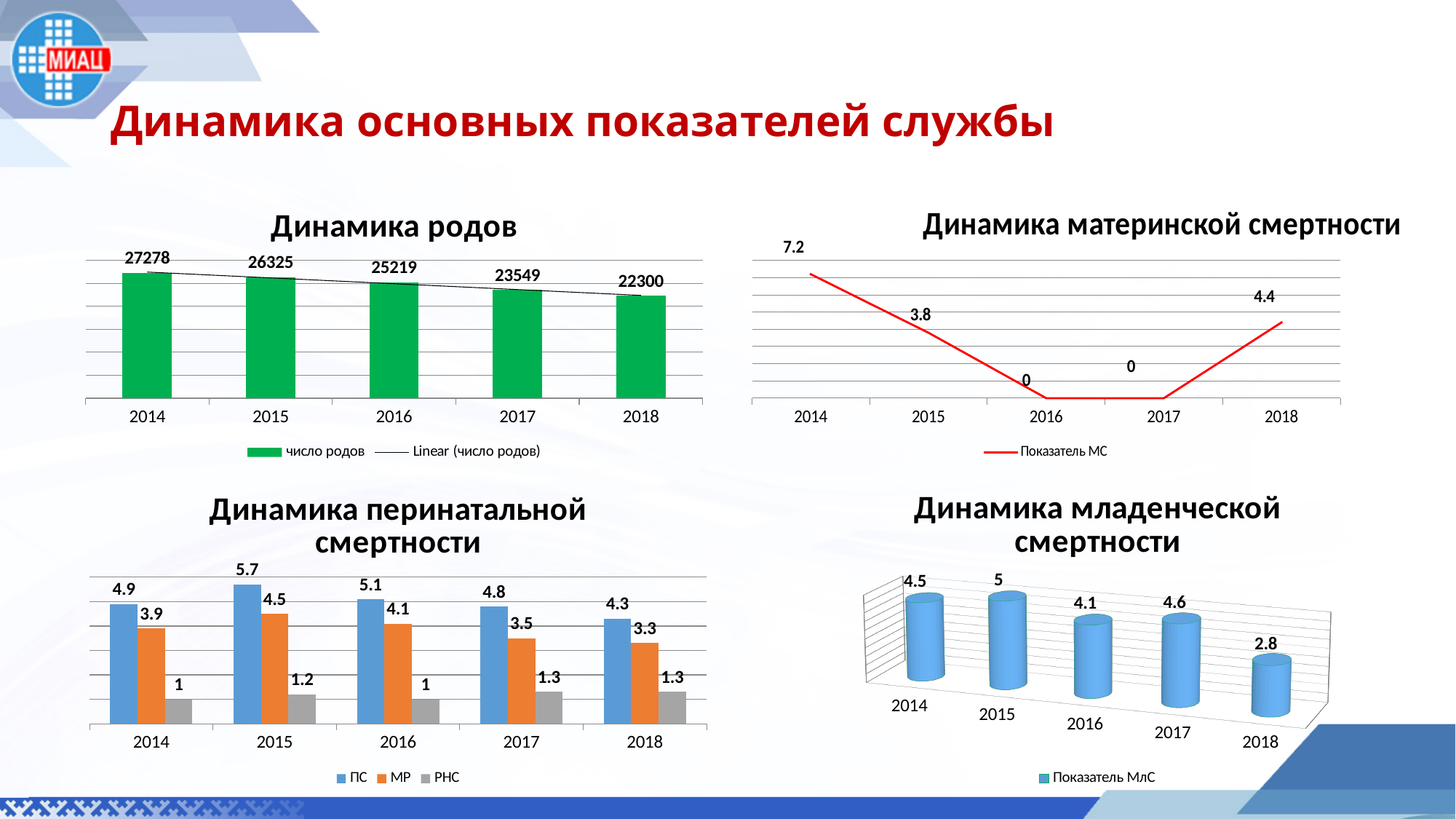
In the 'Динамика перинатальной смертности' chart, what is the value of МР for 2017? 3.5 In the 'Динамика младенческой смертности' chart, which year has the lowest value? 2018 In the 'Динамика перинатальной смертности' chart, which year has the highest ПС value? 2015 In the 'Динамика родов' chart, what is the value for 2016? 25219 How many years are shown on the x axis of the 'Динамика младенческой смертности' chart? 5 In the 'Динамика материнской смертности' chart, what is the value for 2015? 3.8 In the 'Динамика младенческой смертности' chart, what is the value for 2018? 2.8 In the 'Динамика родов' chart, do the values rise or fall from 2014 to 2018? fall How many series does the legend of the 'Динамика перинатальной смертности' chart list? 3 In the 'Динамика материнской смертности' chart, which year has the highest value? 2014 What kind of chart is 'Динамика материнской смертности'? line chart In the 'Динамика родов' chart, what is the difference between the values for 2014 and 2018? 4978